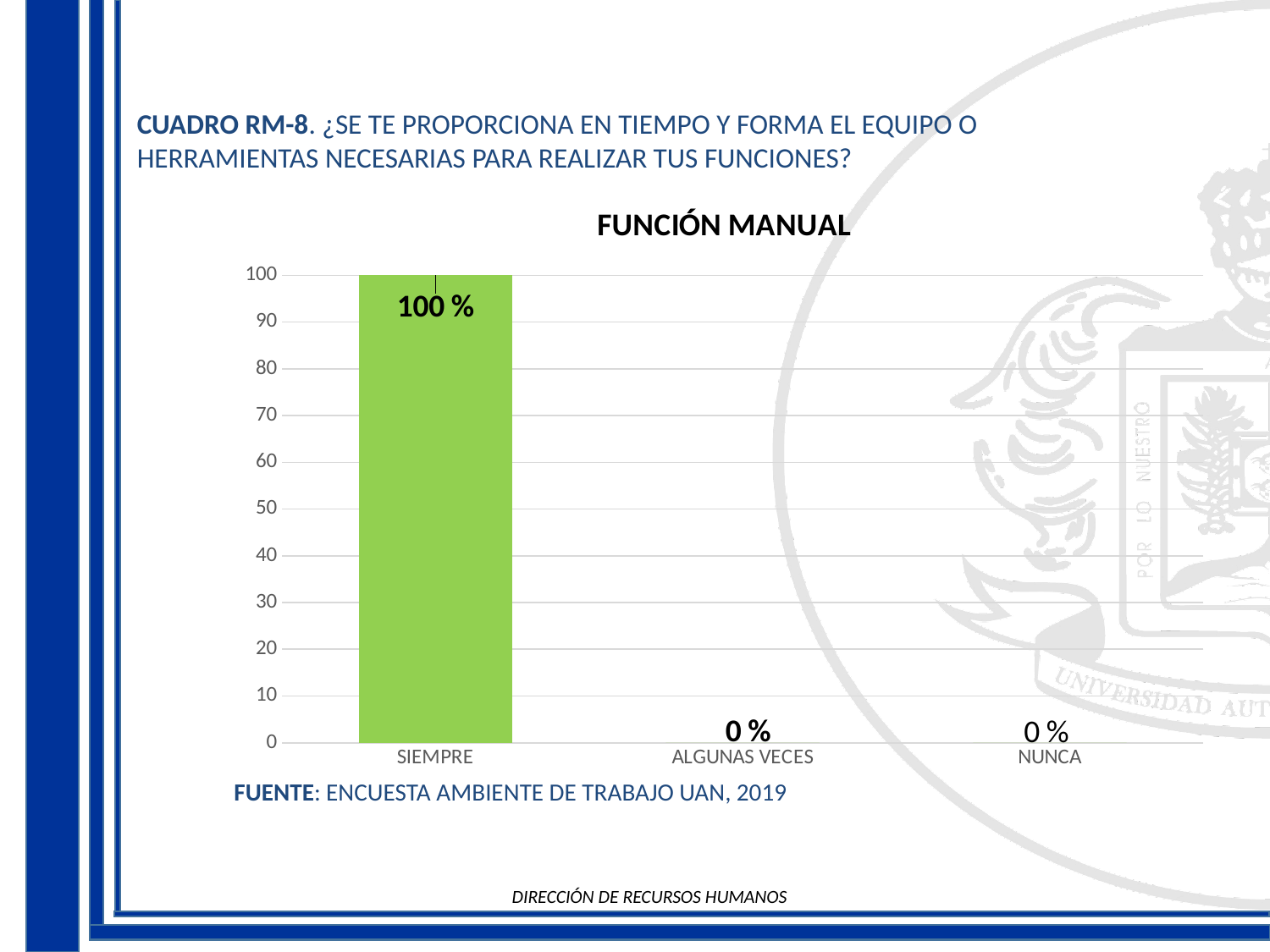
What is the title of the chart? FUNCIÓN MANUAL What kind of chart is shown on the slide? bar chart What colour is the bar for SIEMPRE? green What is the value for SIEMPRE? 100 % Is the value for SIEMPRE greater or less than 50? greater What is the value for NUNCA? 0 % What is the difference between the values for SIEMPRE and ALGUNAS VECES? 100 % What is the highest value shown on the y axis? 100 Which is larger, the value for SIEMPRE or the value for NUNCA? SIEMPRE Which category has the highest value? SIEMPRE How many categories are shown on the x axis? 3 What is the value for ALGUNAS VECES? 0 %